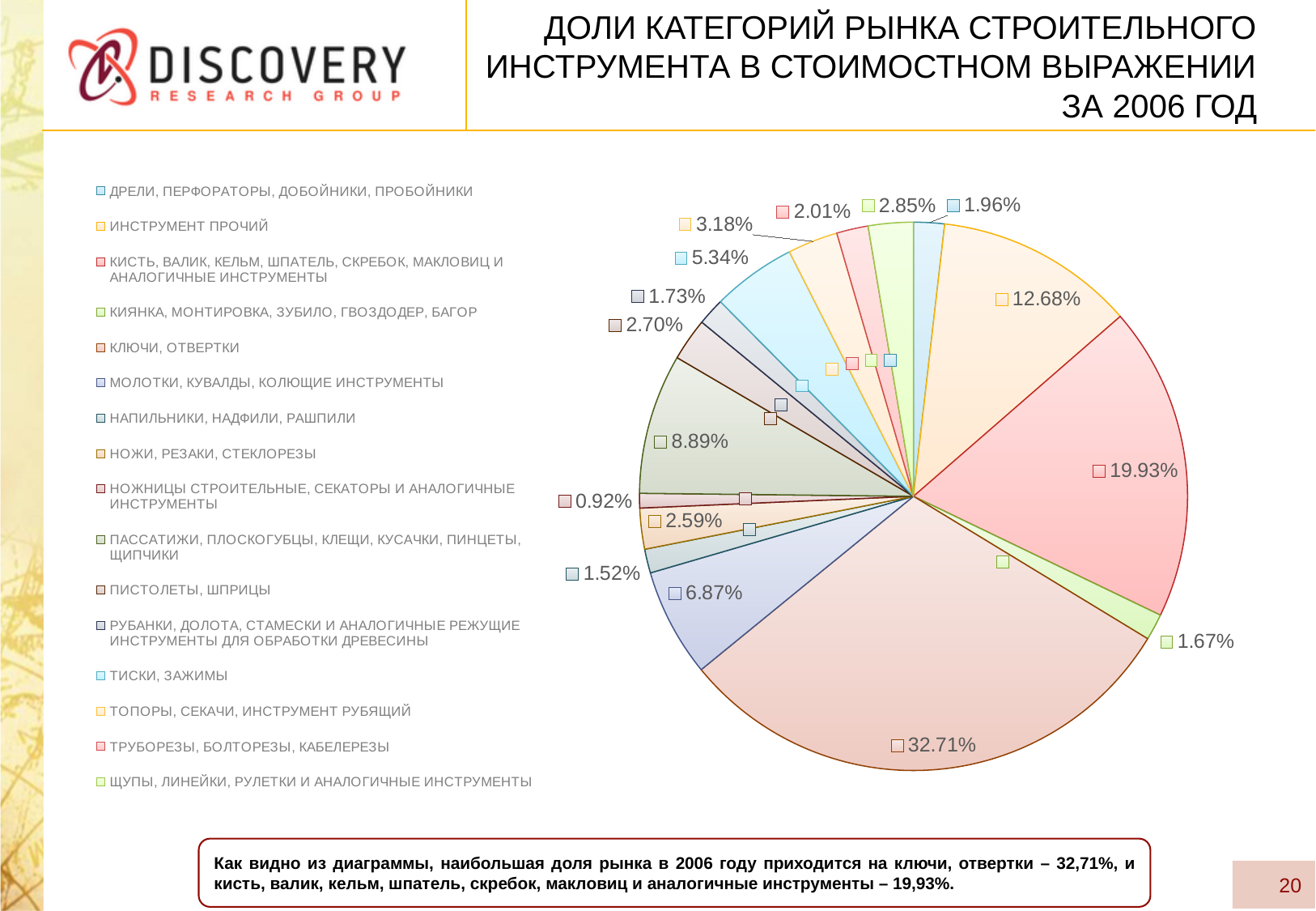
What kind of chart is shown on the slide? Pie chart How many categories does the legend of the pie chart list? 16 What is the smallest share shown on the pie chart? 0.92% Which is larger: the slice labelled 12.68% or the slice labelled 8.89%? 12.68% What is the share of the market for КЛЮЧИ, ОТВЕРТКИ? 32.71% What is the largest share shown on the pie chart? 32.71% What is the title of the slide containing the pie chart? ДОЛИ КАТЕГОРИЙ РЫНКА СТРОИТЕЛЬНОГО ИНСТРУМЕНТА В СТОИМОСТНОМ ВЫРАЖЕНИИ ЗА 2006 ГОД What is the difference between the slices labelled 12.68% and 8.89%? 3.79% By how many percentage points does the share of КЛЮЧИ, ОТВЕРТКИ exceed the share of КИСТЬ, ВАЛИК, КЕЛЬМ, ШПАТЕЛЬ, СКРЕБОК, МАКЛОВИЦ И АНАЛОГИЧНЫЕ ИНСТРУМЕНТЫ? 12.78% Which year does the pie chart describe? 2006 What is the share of the market for КИСТЬ, ВАЛИК, КЕЛЬМ, ШПАТЕЛЬ, СКРЕБОК, МАКЛОВИЦ И АНАЛОГИЧНЫЕ ИНСТРУМЕНТЫ? 19.93% Which category has the largest share of the construction tool market in 2006? КЛЮЧИ, ОТВЕРТКИ